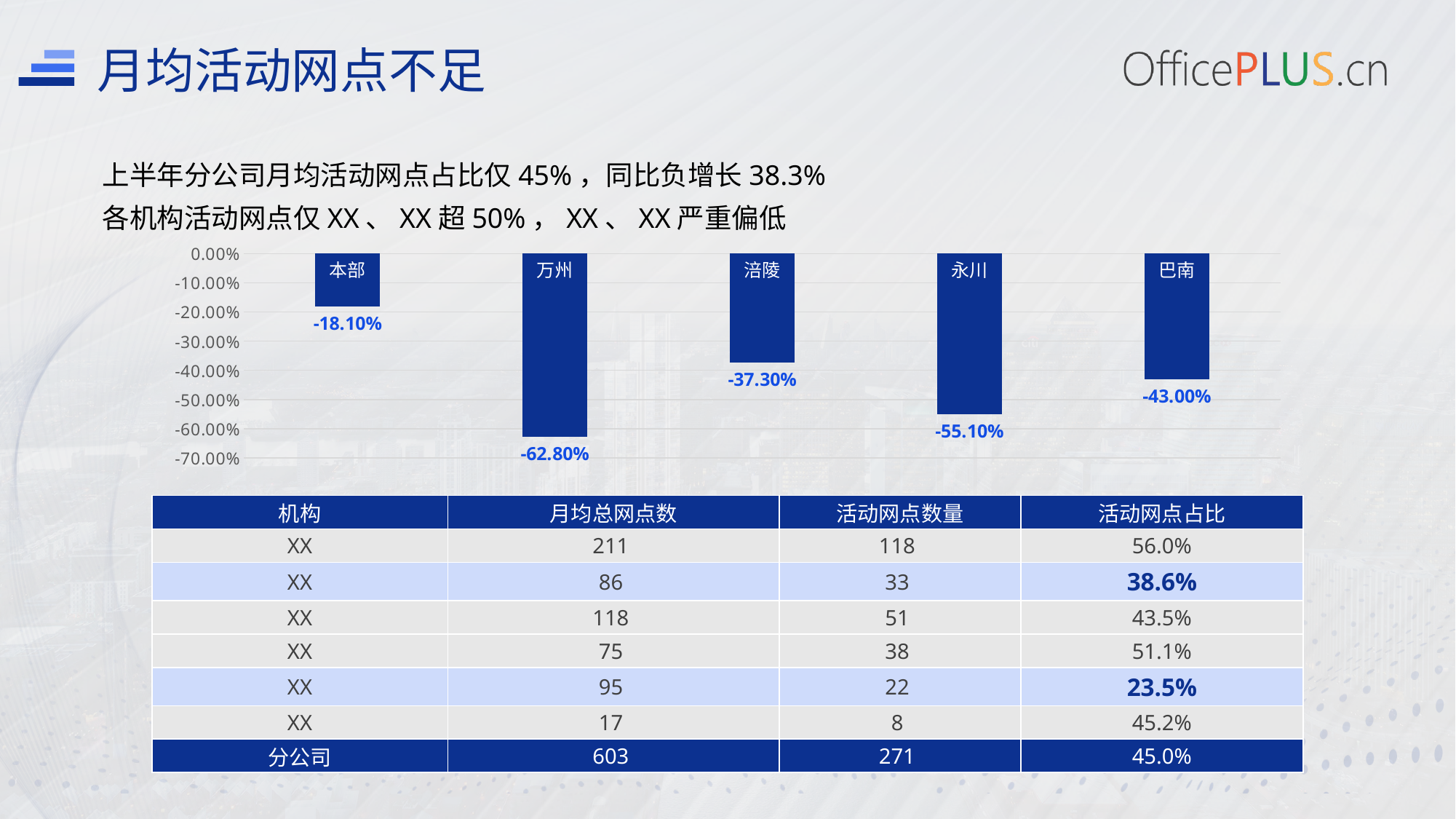
What is the difference between the values for 万州 and 本部 in the bar chart? 44.70 percentage points What is the value for 本部 in the bar chart? -18.10% What is the lowest value shown on the vertical axis of the bar chart? -70.00% What is the value for 永川 in the bar chart? -55.10% What kind of chart is shown on the slide? Bar chart Which category has the lowest (most negative) value in the bar chart? 万州 How many categories are shown in the bar chart? 5 What is the value for 万州 in the bar chart? -62.80% What is the value for 涪陵 in the bar chart? -37.30% What is the value for 巴南 in the bar chart? -43.00% Which category has the highest (least negative) value in the bar chart? 本部 Which has a larger (less negative) value in the bar chart, 涪陵 or 巴南? 涪陵